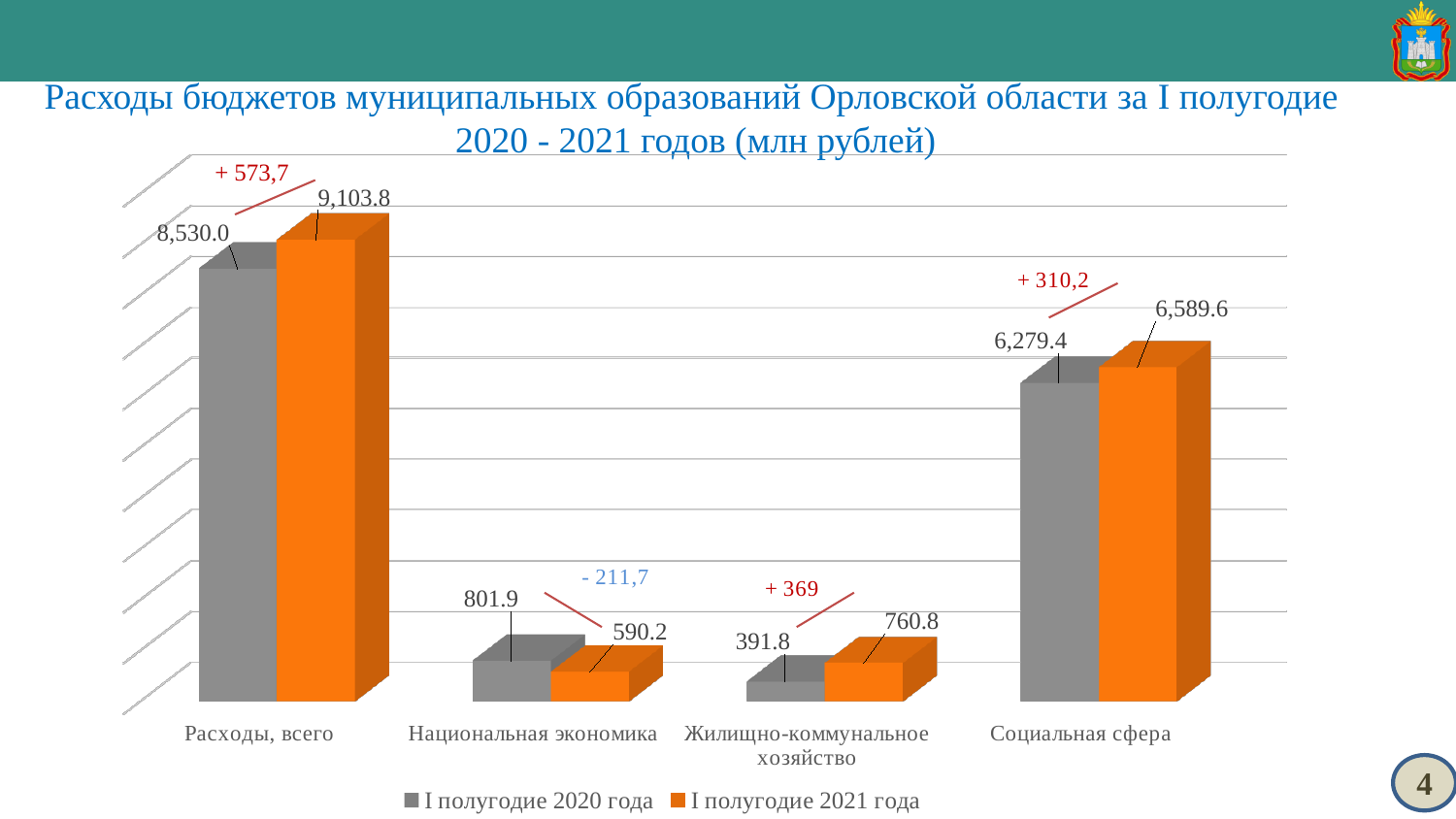
Which colour represents I полугодие 2021 года in the chart? Orange How many series does the legend list? 2 What is the value for Национальная экономика in I полугодие 2021 года? 590.2 What kind of chart is shown on the slide? Bar chart How many categories are shown on the x axis? 4 What is the value for Социальная сфера in I полугодие 2020 года? 6,279.4 Which is larger for Национальная экономика: the I полугодие 2020 года value or the I полугодие 2021 года value? I полугодие 2020 года Which category has the highest value in I полугодие 2021 года? Расходы, всего What is the difference between the I полугодие 2021 года and I полугодие 2020 года values for Социальная сфера? 310.2 What is the value for Жилищно-коммунальное хозяйство in I полугодие 2020 года? 391.8 What is the value for Расходы, всего in I полугодие 2021 года? 9,103.8 Which category has the lowest value in I полугодие 2020 года? Жилищно-коммунальное хозяйство